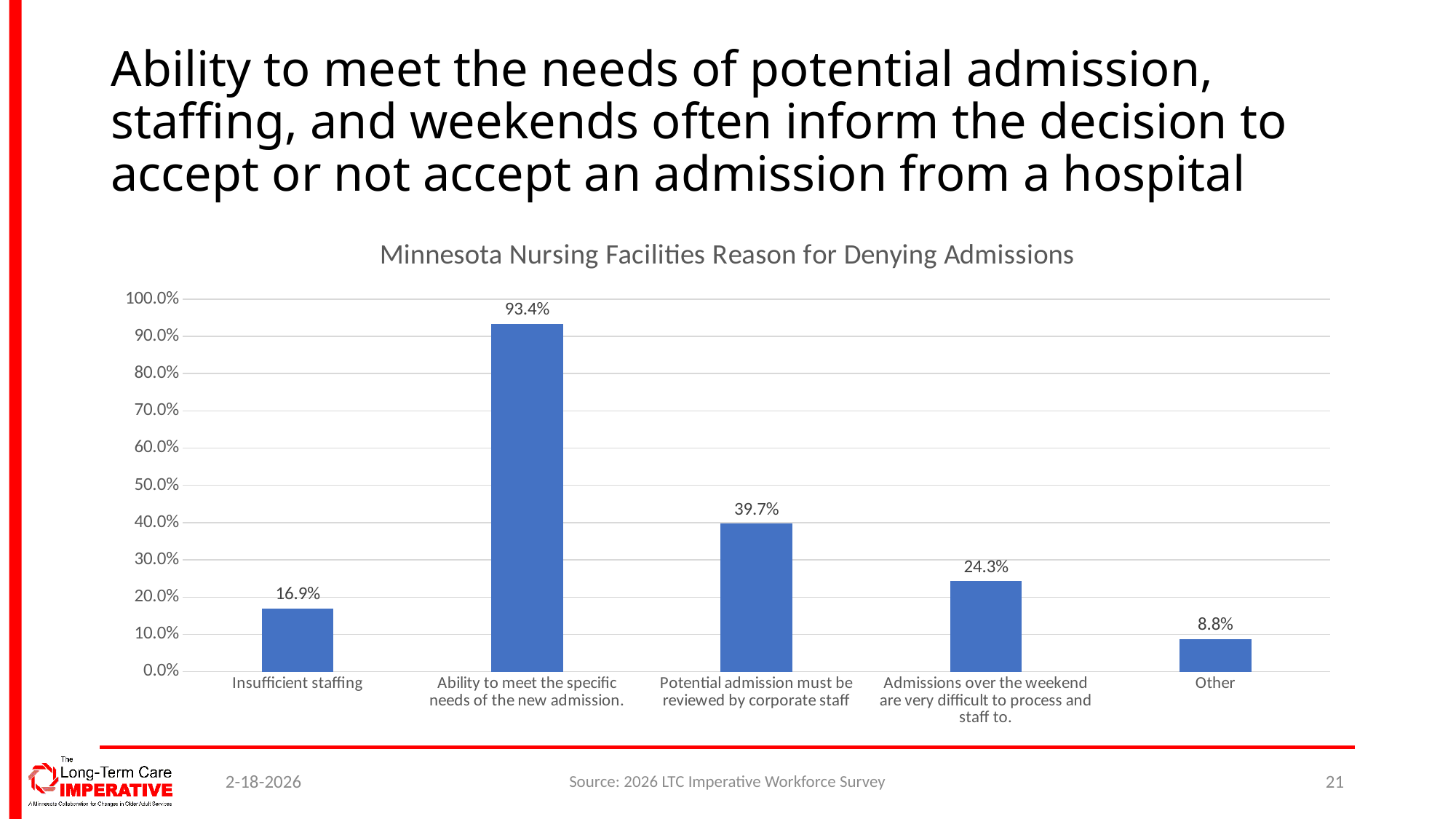
Which is larger, the value for Insufficient staffing or the value for Other? Insufficient staffing Which category has the lowest value? Other What kind of chart is shown on the slide? bar chart How many categories are shown in the chart? 5 What is the value for Other? 8.8% What is the value for Ability to meet the specific needs of the new admission? 93.4% What is the value for Insufficient staffing? 16.9% What is the difference between the values for Potential admission must be reviewed by corporate staff and Admissions over the weekend are very difficult to process and staff to? 15.4% What is the value for Potential admission must be reviewed by corporate staff? 39.7% Which category has the highest value? Ability to meet the specific needs of the new admission. Is the value for Admissions over the weekend are very difficult to process and staff to greater or less than 20.0%? greater What is the title of the chart? Minnesota Nursing Facilities Reason for Denying Admissions